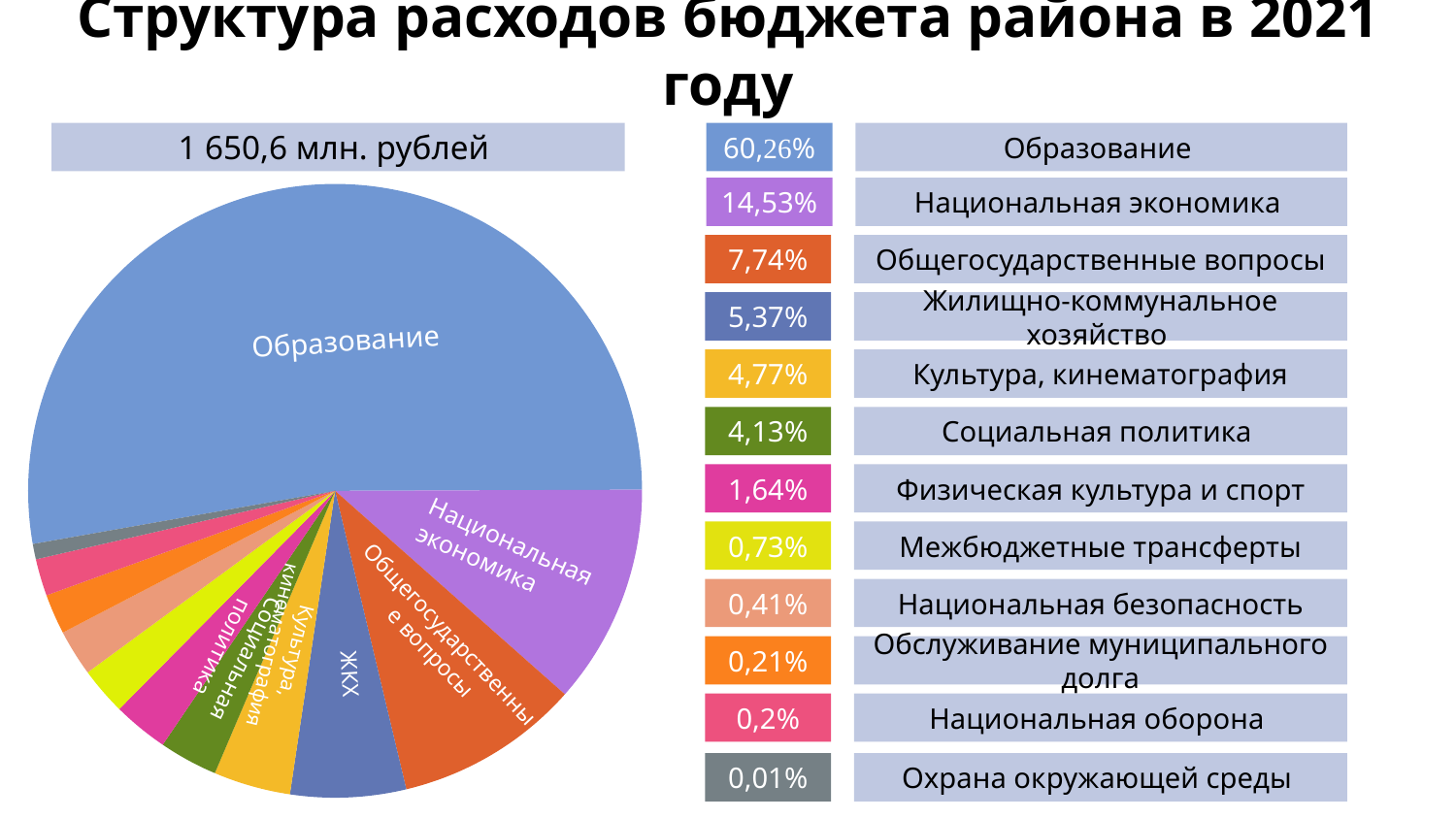
На сколько процентных пунктов доля образования больше доли национальной экономики? 45,73% Какая доля приходится на обслуживание муниципального долга? 0,21% Какой тип диаграммы показан на слайде? Круговая диаграмма Какая доля приходится на национальную экономику? 14,53% Какая статья расходов имеет наименьшую долю? Охрана окружающей среды Какую долю расходов бюджета района в 2021 году составляет образование? 60,26% Каким цветом на диаграмме обозначено образование? Синим Что больше: доля культуры и кинематографии или доля социальной политики? Культура, кинематография Какая доля приходится на жилищно-коммунальное хозяйство? 5,37% Какая статья расходов имеет наибольшую долю? Образование Сколько статей расходов показано на диаграмме? 12 Какой общий объём расходов бюджета района указан на слайде? 1 650,6 млн. рублей